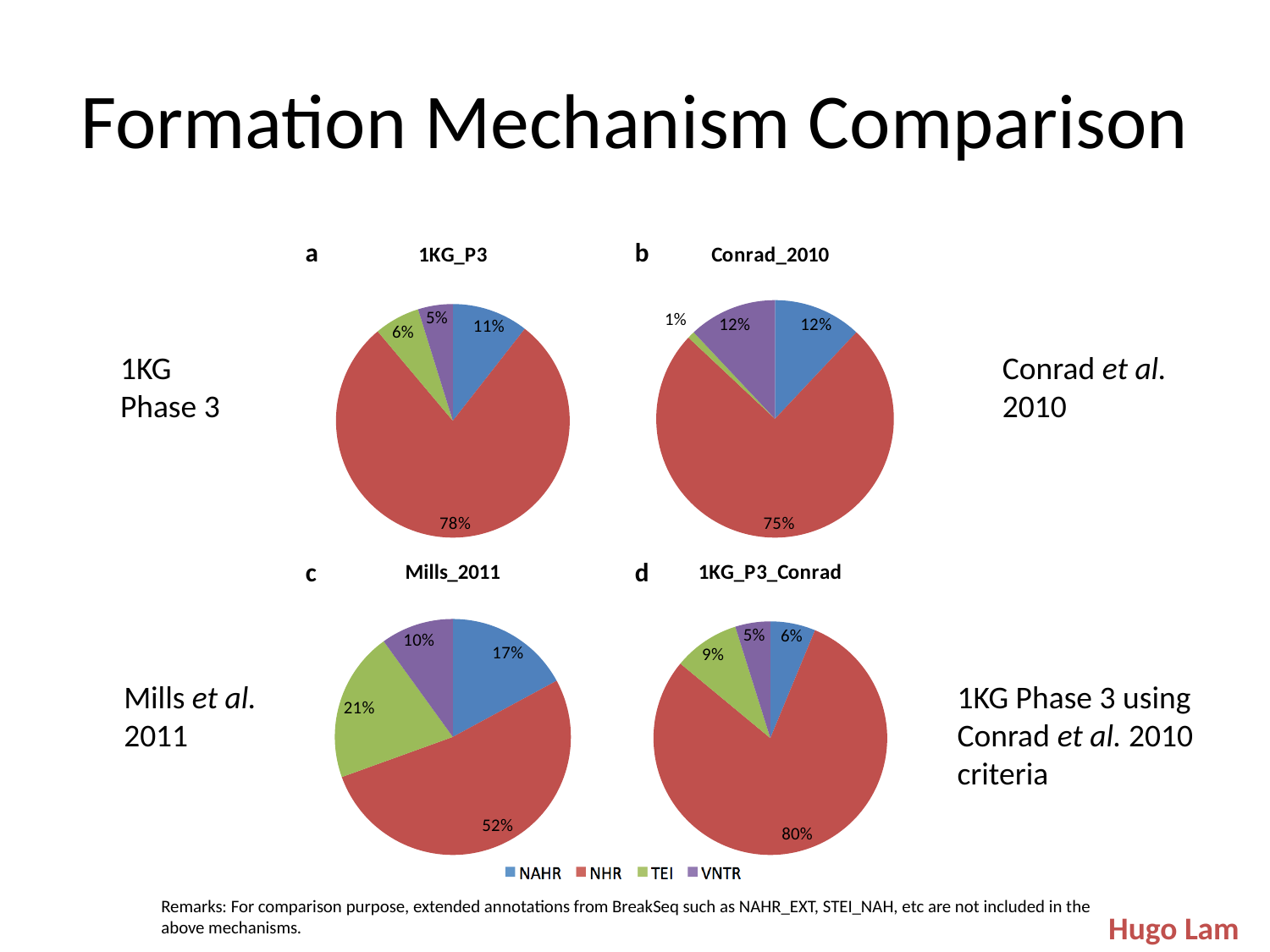
In the 1KG_P3 pie chart, what share does NHR have? 78% In the Conrad_2010 pie chart, which mechanism has the smallest share? TEI How many slices does the 1KG_P3_Conrad pie chart have? 4 In the Mills_2011 pie chart, what share does TEI have? 21% What type of chart is the Conrad_2010 chart? Pie chart Which colour represents VNTR in the legend? Purple How many entries does the legend at the bottom of the slide list? 4 In the Mills_2011 pie chart, which mechanism has the largest share? NHR In the Mills_2011 pie chart, which is larger, the NAHR share or the TEI share? TEI In the 1KG_P3 pie chart, what is the difference between the NHR share and the NAHR share? 67% In the 1KG_P3_Conrad pie chart, what share does NHR have? 80%